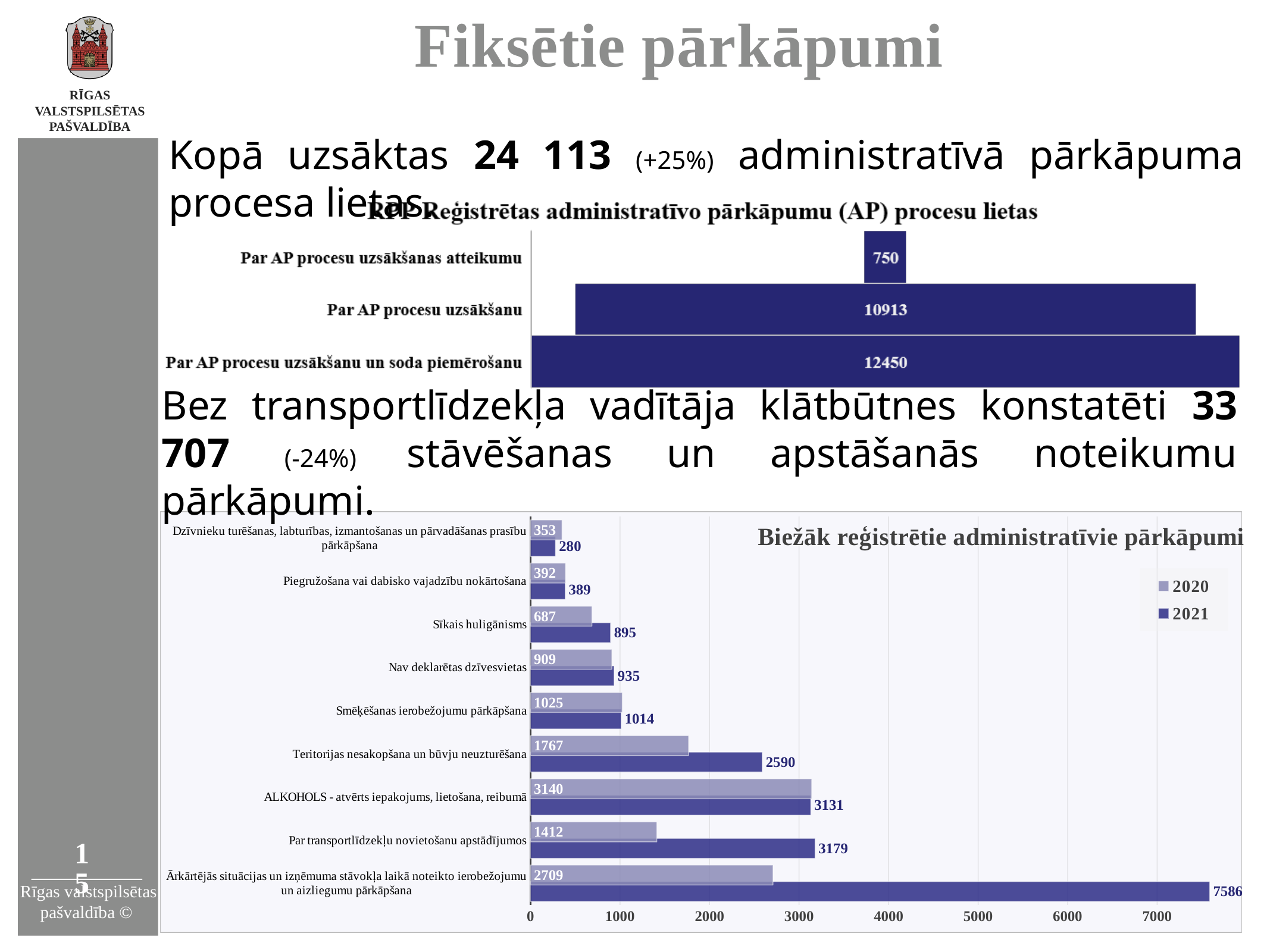
In the chart 'Reģistrētas administratīvo pārkāpumu (AP) procesu lietas', what is the difference between 'Par AP procesu uzsākšanu un soda piemērošanu' and 'Par AP procesu uzsākšanu'? 1537 What kind of chart is 'Biežāk reģistrētie administratīvie pārkāpumi'? bar chart In the chart 'Reģistrētas administratīvo pārkāpumu (AP) procesu lietas', what is the value for 'Par AP procesu uzsākšanu'? 10913 In the chart 'Biežāk reģistrētie administratīvie pārkāpumi', what is the difference between the 2021 and 2020 values for 'Teritorijas nesakopšana un būvju neuzturēšana'? 823 How many categories are shown in the chart 'Biežāk reģistrētie administratīvie pārkāpumi'? 9 In the chart 'Biežāk reģistrētie administratīvie pārkāpumi', is the 2020 value for 'Par transportlīdzekļu novietošanu apstādījumos' larger or smaller than the 2021 value? smaller In the chart 'Reģistrētas administratīvo pārkāpumu (AP) procesu lietas', which category has the lowest value? Par AP procesu uzsākšanas atteikumu How many categories are shown in the chart 'Reģistrētas administratīvo pārkāpumu (AP) procesu lietas'? 3 In the chart 'Biežāk reģistrētie administratīvie pārkāpumi', how many series does the legend list? 2 In the chart 'Biežāk reģistrētie administratīvie pārkāpumi', which category has the highest 2021 value? Ārkārtējās situācijas un izņēmuma stāvokļa laikā noteikto ierobežojumu un aizliegumu pārkāpšana In the chart 'Biežāk reģistrētie administratīvie pārkāpumi', what is the 2021 value for 'Par transportlīdzekļu novietošanu apstādījumos'? 3179 In the chart 'Biežāk reģistrētie administratīvie pārkāpumi', what is the 2020 value for 'Sīkais huligānisms'? 687